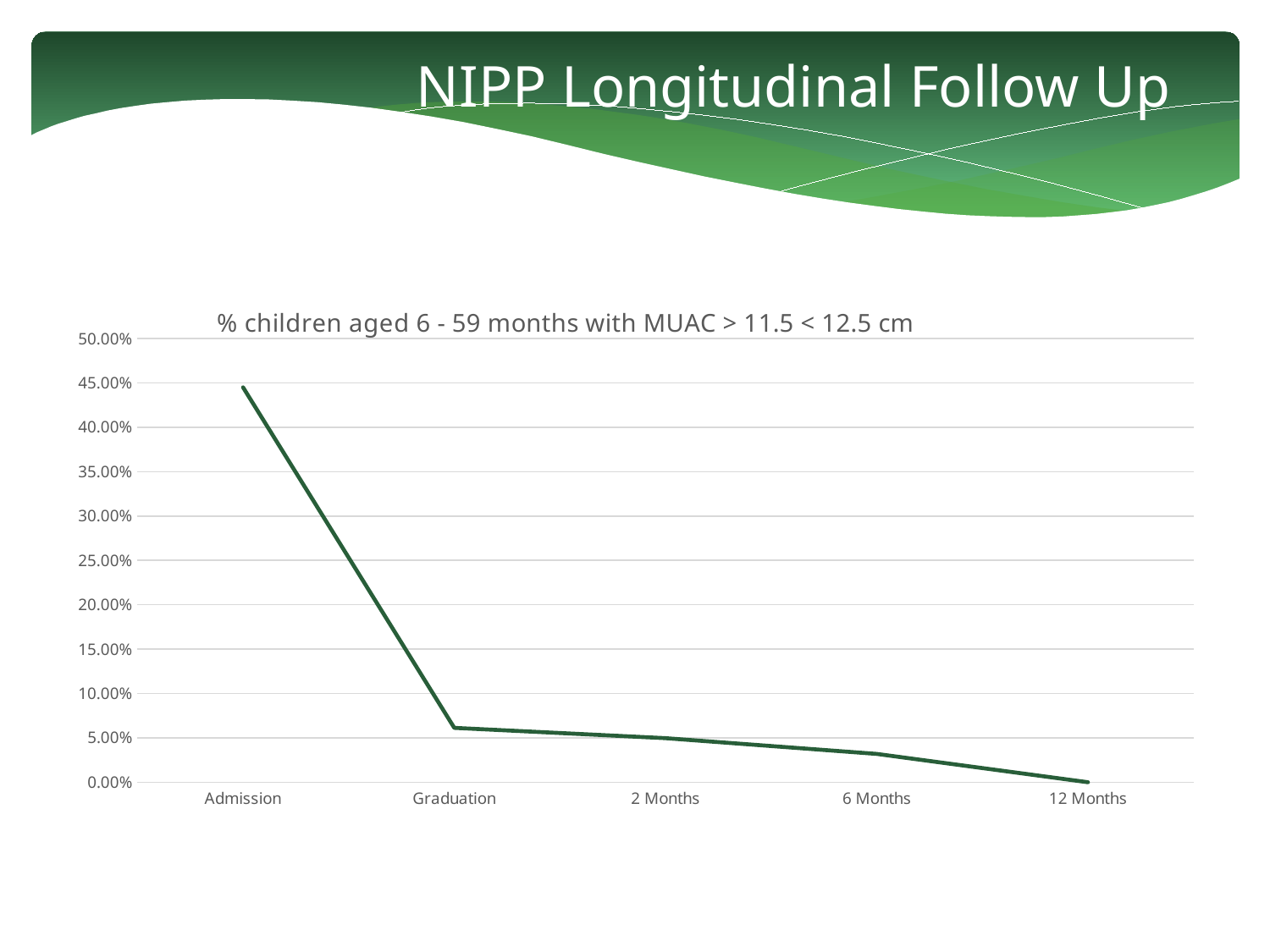
Is the value at 2 Months greater or less than 10.00%? less Is the value at Admission greater or less than 50.00%? less Which time point has the lowest value? 12 Months Which time point has the highest value? Admission Is the value at Admission greater or less than 40.00%? greater What is the title of the chart? % children aged 6 - 59 months with MUAC > 11.5 < 12.5 cm Which is larger, the value at Admission or the value at Graduation? Admission How many time points are plotted along the x axis? 5 What kind of chart is shown on the slide? line chart Do the values rise or fall from Admission to 12 Months? fall